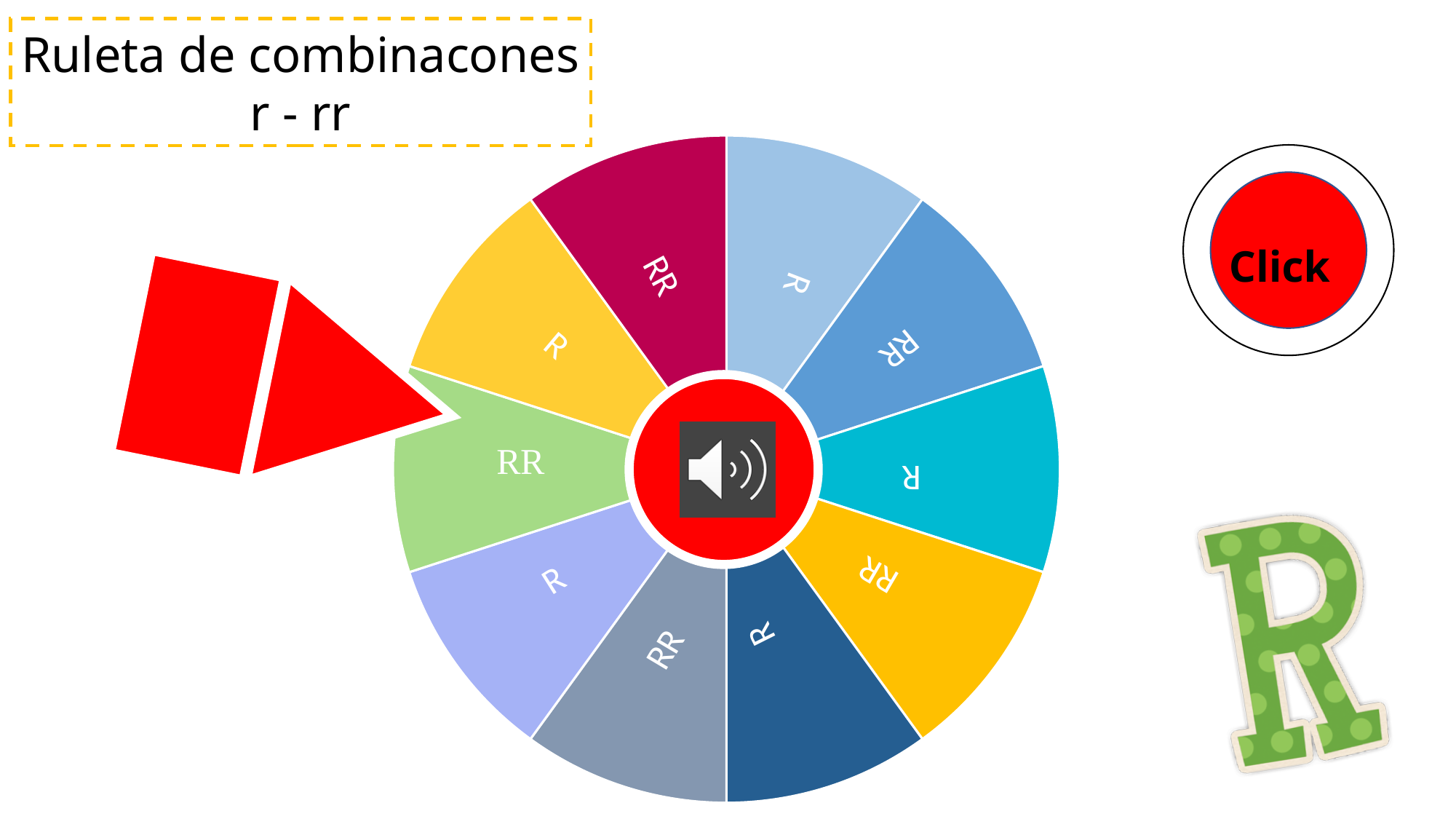
What label is on the dark magenta slice at the top left of the wheel? RR What icon is shown in the centre of the wheel? a speaker (sound) icon How many slices does the wheel have? 10 What is the title shown above the wheel? Ruleta de combinacones r - rr How many slices of the wheel are labelled "R"? 5 What label is on the cyan slice on the right side of the wheel? R What kind of chart is the wheel on the slide? pie chart What label is on the green slice that the red arrow points to? RR How many slices of the wheel are labelled "RR"? 5